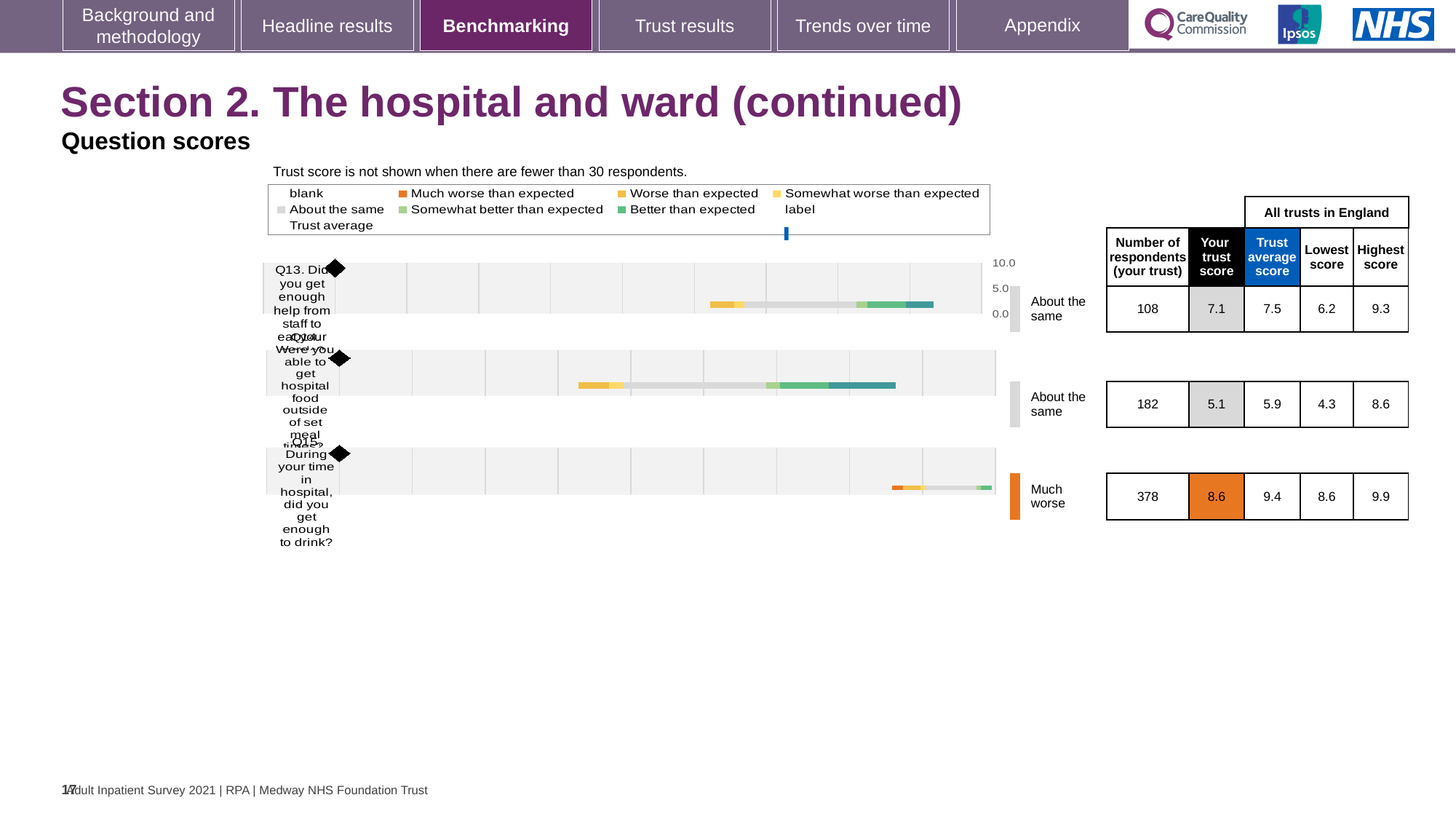
What is the 'Your trust score' for Q14 (Were you able to get hospital food outside of set meal times)? 5.1 How many respondents answered Q15 at this trust? 378 What kind of chart is used to show the question scores on this slide? bar chart Which question has the lowest 'Your trust score'? Q14 What is the 'Your trust score' for Q15 (did you get enough to drink)? 8.6 What benchmark category is shown for Q15? Much worse What is the 'Your trust score' for Q13 (Did you get enough help from staff to eat your meals)? 7.1 What is the difference between the trust average score and 'Your trust score' for Q13? 0.4 Which is larger, the 'Your trust score' for Q13 or for Q14? Q13 Which question has the highest number of respondents? Q15 How many questions (rows) are plotted in the chart? 3 What is the trust average score across all trusts in England for Q14? 5.9